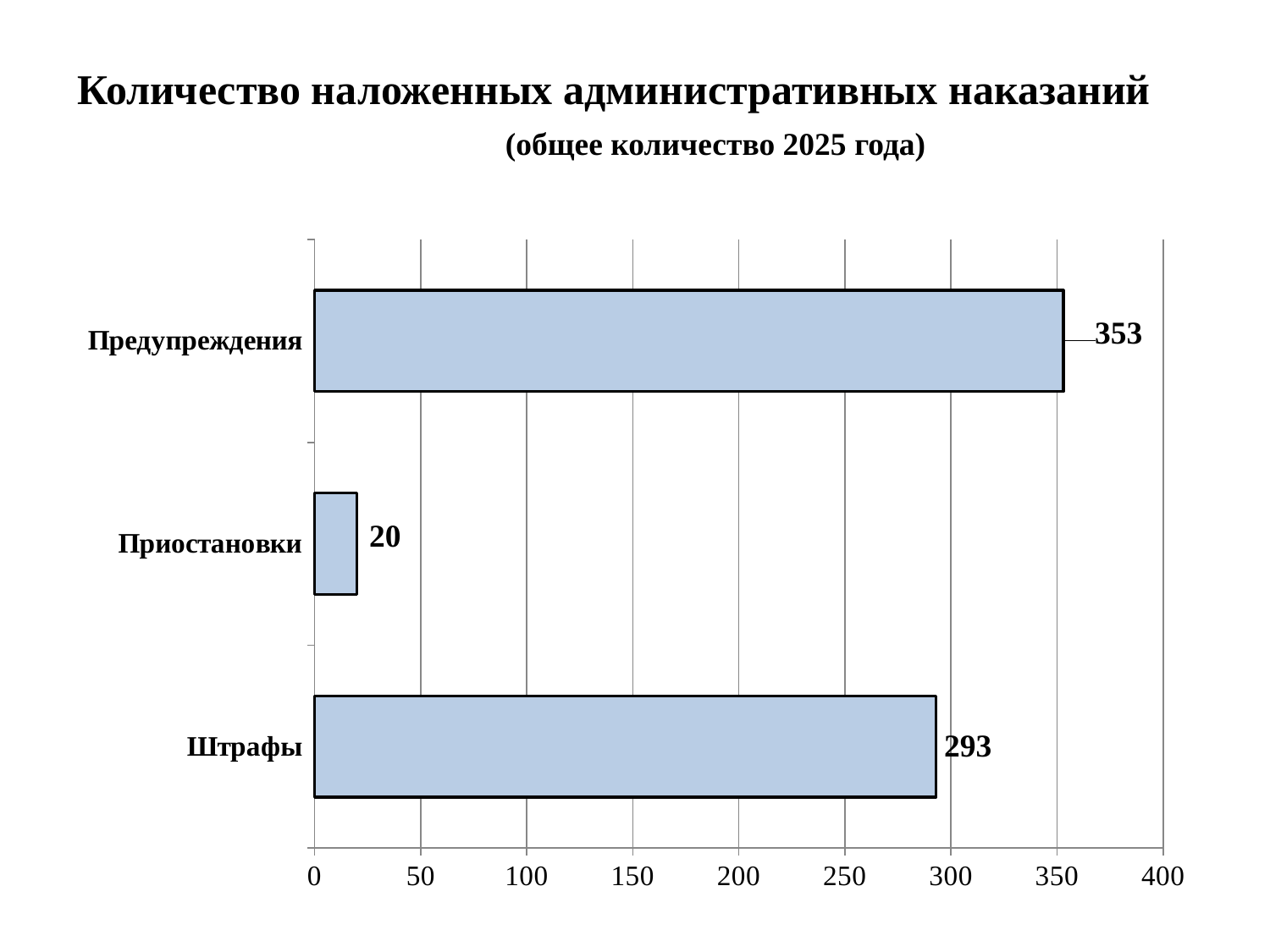
How many categories are shown in the chart? 3 What is the value for Приостановки? 20 What is the title of the chart? Количество наложенных административных наказаний (общее количество 2025 года) Is the value for Штрафы greater or less than 250? greater Which is larger, the value for Штрафы or the value for Приостановки? Штрафы What is the value for Штрафы? 293 Which category has the lowest value? Приостановки What kind of chart is shown on the slide? bar chart Which category has the highest value? Предупреждения What is the value for Предупреждения? 353 What is the difference between the values for Штрафы and Приостановки? 273 What is the difference between the values for Предупреждения and Штрафы? 60